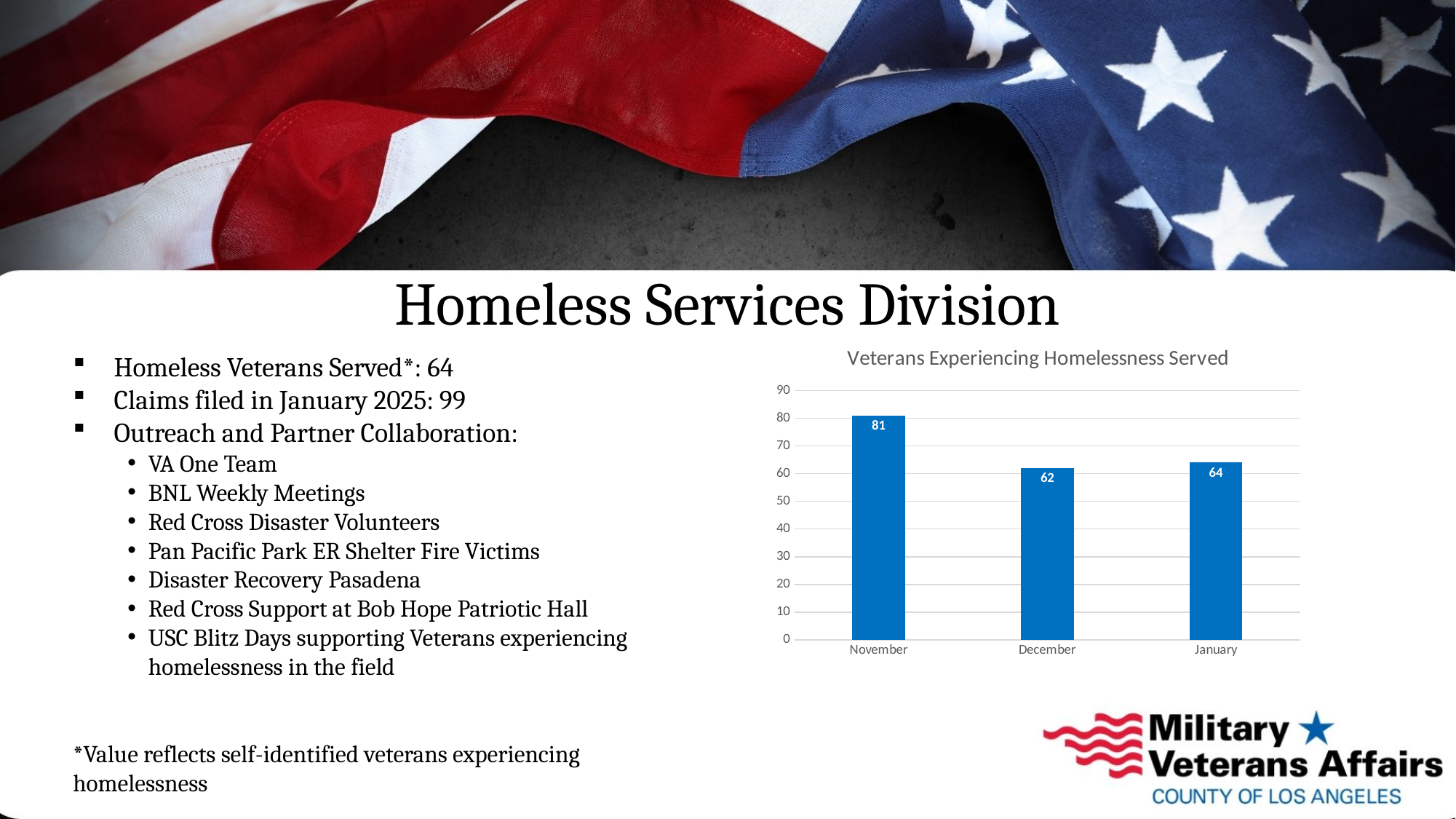
Is the value for November greater or less than 70? greater What kind of chart is shown on the slide? bar chart What is the value for January in the chart? 64 What is the title of the chart? Veterans Experiencing Homelessness Served Which is larger, the value for November or the value for January? November What is the difference between the January and December values? 2 How many months are shown on the x axis of the chart? 3 What is the value for December in the chart? 62 Which month has the highest value in the chart? November What is the value for November in the chart? 81 Which month has the lowest value in the chart? December What is the difference between the November and December values? 19